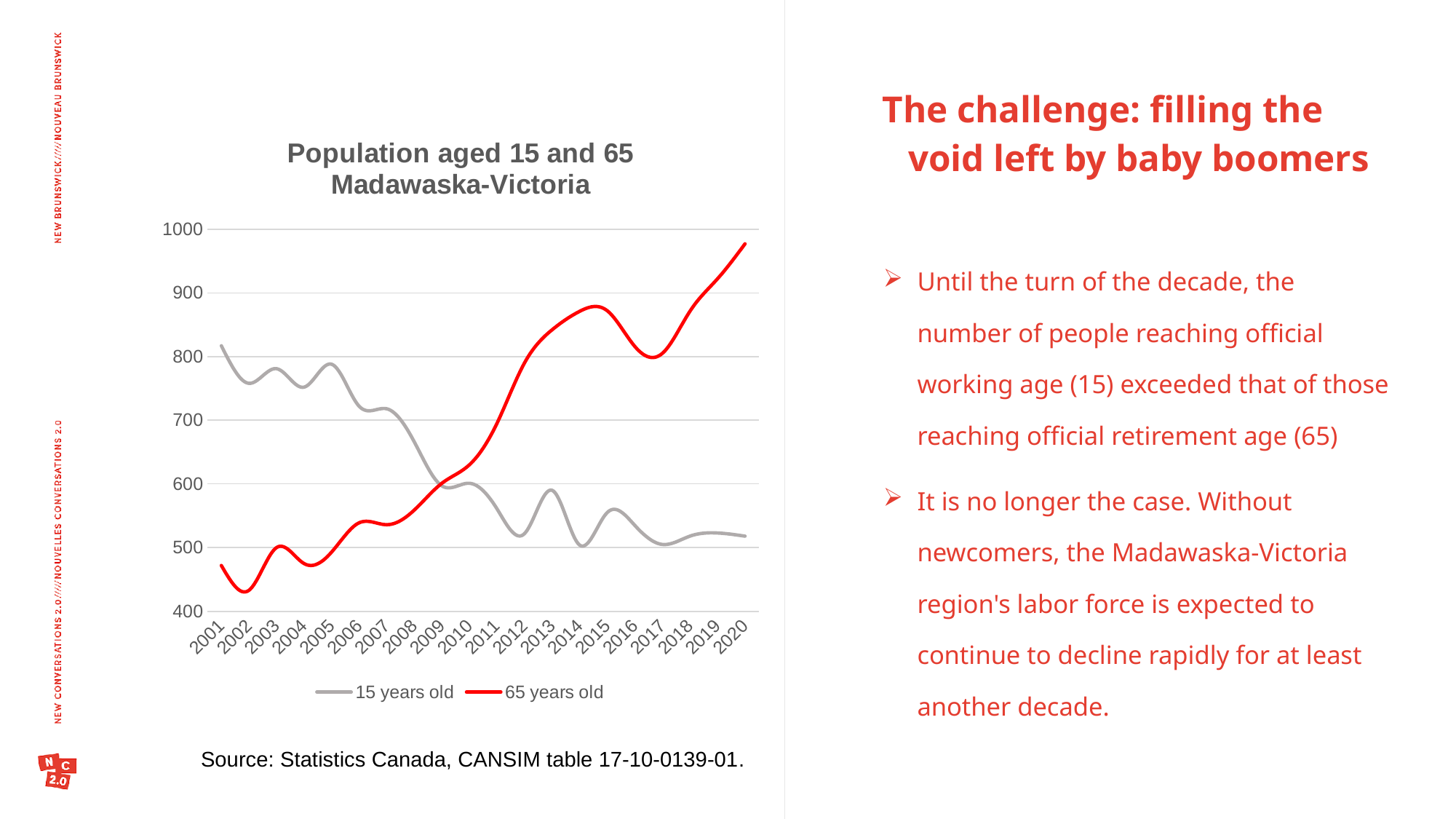
Is the value for 65 years old in 2020 greater or less than 900? greater How many series does the legend list? 2 In 2020, which series has the larger value, 15 years old or 65 years old? 65 years old Does the 15 years old series rise or fall overall from 2001 to 2020? Fall Does the 65 years old series rise or fall overall from 2001 to 2020? Rise What is the title of the chart? Population aged 15 and 65 Madawaska-Victoria What kind of chart is shown on the slide? Line chart Is the value for 15 years old in 2012 greater or less than 600? less Which colour is used for the 65 years old series? Red Is the value for 65 years old in 2002 greater or less than 500? less In which year does the 65 years old series reach its highest value? 2020 How many years are plotted along the x axis? 20